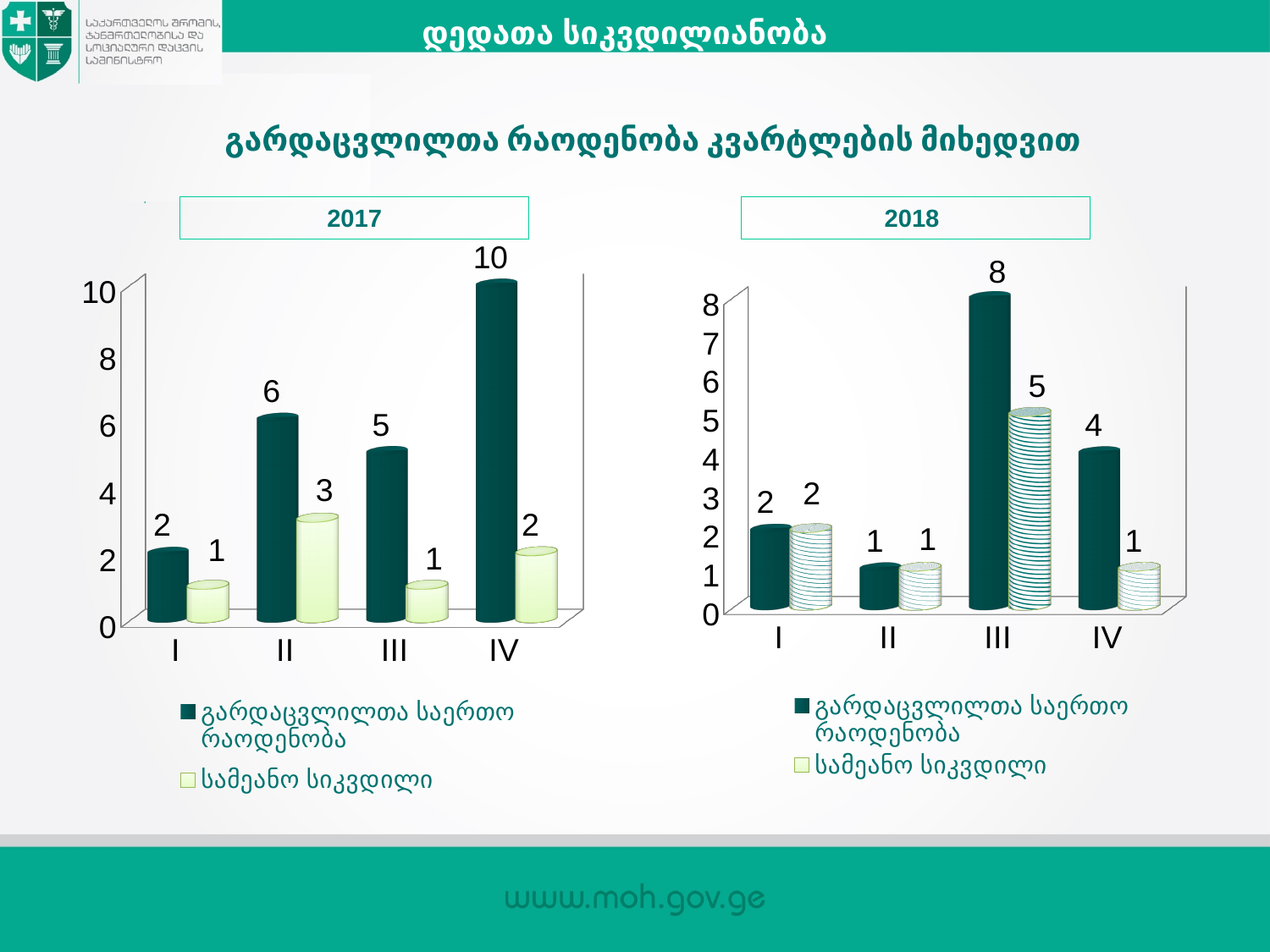
Which is larger: გარდაცვლილთა საერთო რაოდენობა for quarter II in the 2017 chart or for quarter III in the 2018 chart? quarter III in the 2018 chart In the 2017 chart, which quarter has the highest value for გარდაცვლილთა საერთო რაოდენობა? IV What type of chart is the 2018 chart? bar chart In the 2018 chart, what is the value of გარდაცვლილთა საერთო რაოდენობა for quarter IV? 4 In the 2018 chart, which quarter has the lowest value for გარდაცვლილთა საერთო რაოდენობა? II How many series does the legend of the 2017 chart list? 2 In the 2017 chart, what is the difference between გარდაცვლილთა საერთო რაოდენობა and სამეანო სიკვდილი in quarter IV? 8 In the 2017 chart, what is the value of გარდაცვლილთა საერთო რაოდენობა for quarter IV? 10 In the 2018 chart, what is the difference between გარდაცვლილთა საერთო რაოდენობა in quarter III and quarter I? 6 How many quarters are shown on the x axis of the 2018 chart? 4 In the 2017 chart, what is the value of სამეანო სიკვდილი for quarter II? 3 In the 2018 chart, what is the value of სამეანო სიკვდილი for quarter III? 5